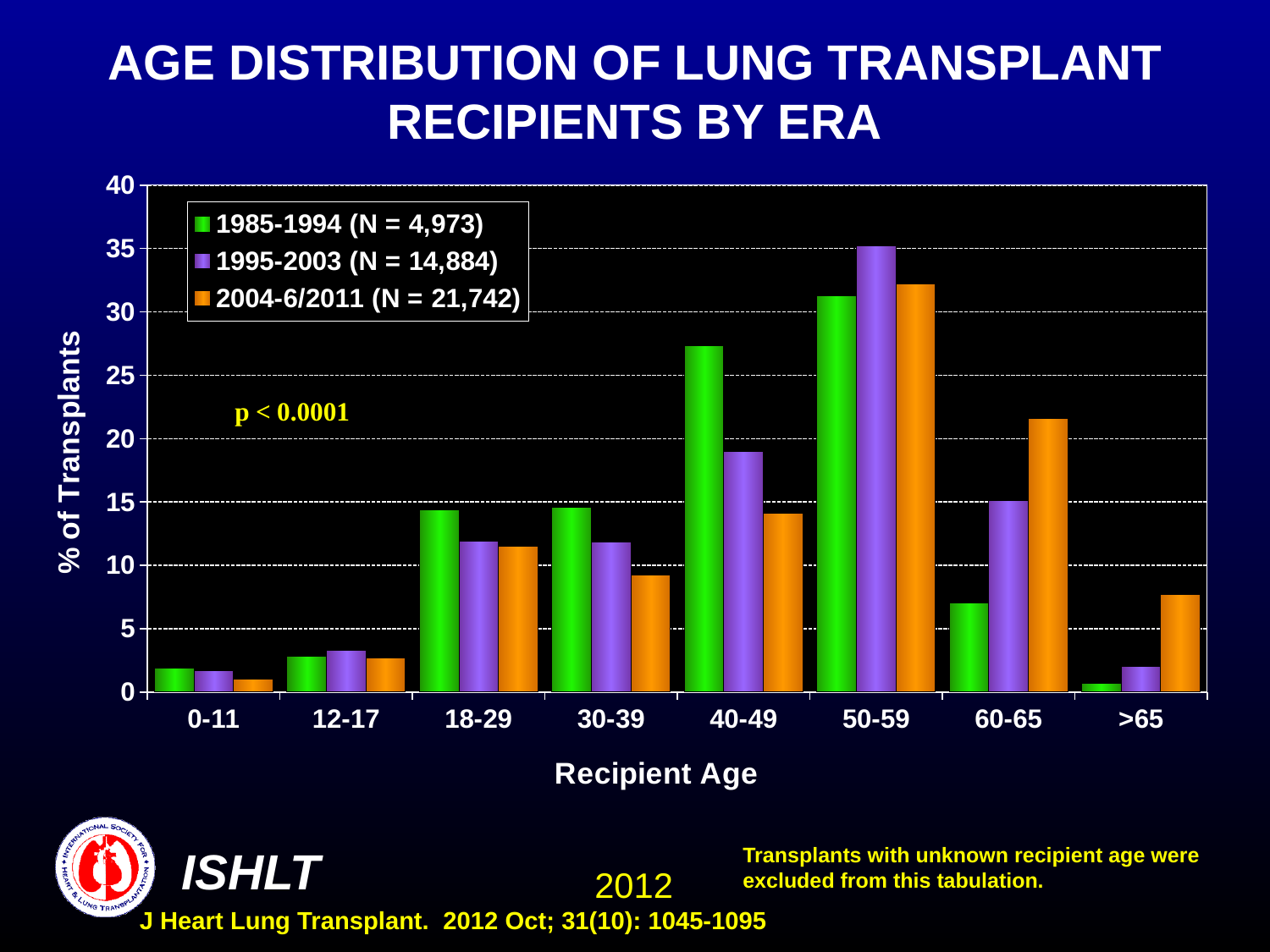
In the 40-49 age group, which era has the larger % of transplants: 1985-1994 or 1995-2003? 1985-1994 What is the N shown in the legend for the 1995-2003 era? 14,884 What kind of chart is shown on the slide? bar chart How many series does the legend list? 3 Is the value for the 1995-2003 era in the 50-59 age group greater or less than 30? greater In the 60-65 age group, which era has the larger % of transplants: 1985-1994 or 2004-6/2011? 2004-6/2011 Is the value for the 2004-6/2011 era in the >65 age group greater or less than 5? greater Is the value for the 2004-6/2011 era in the 60-65 age group greater or less than 20? greater How many recipient age groups are shown on the x axis? 8 Which recipient age group has the lowest % of transplants for the 2004-6/2011 era? 0-11 Which recipient age group has the highest % of transplants for the 1995-2003 era? 50-59